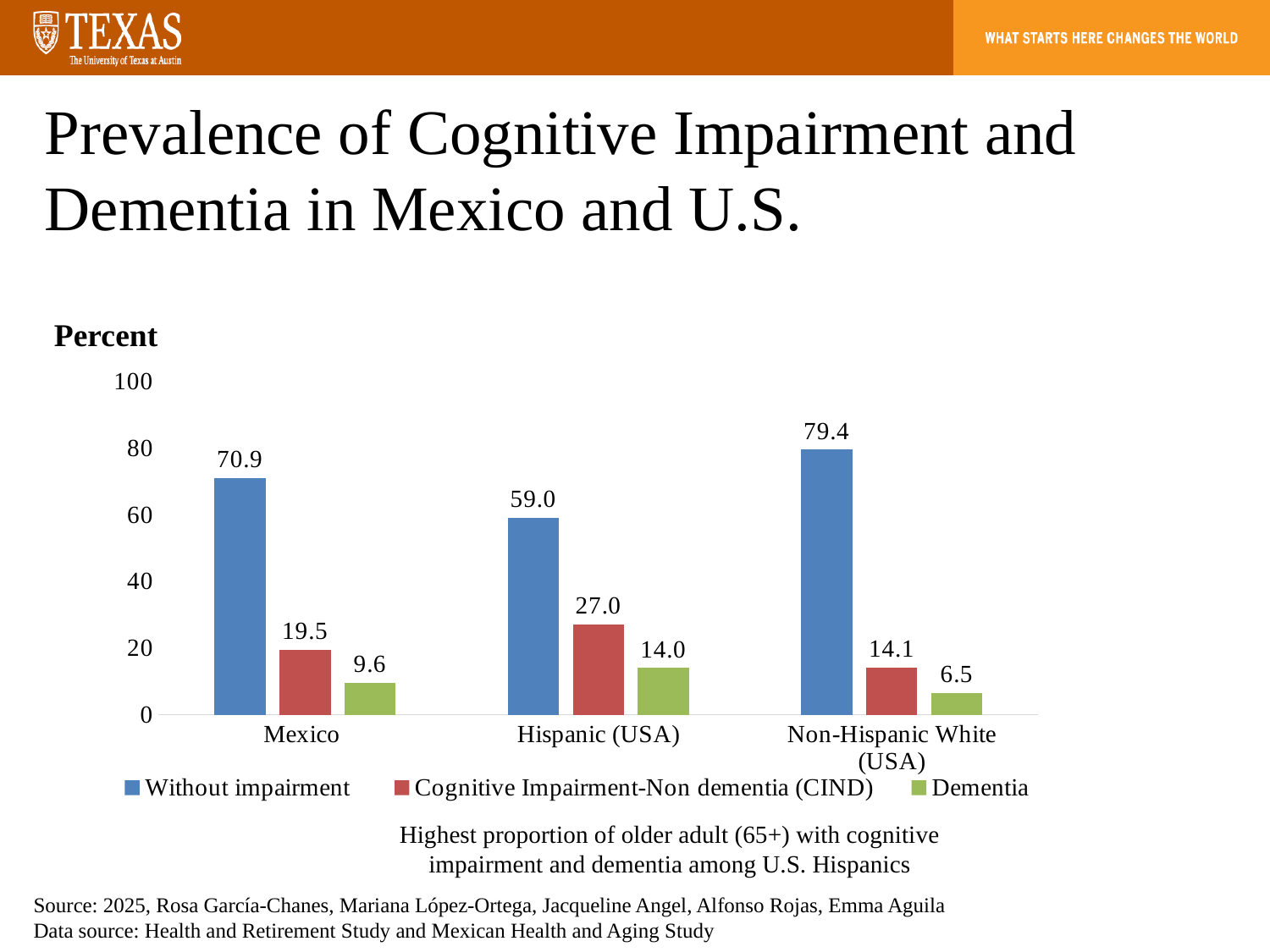
Is the value for Without impairment for Hispanic (USA) greater or less than 60? less How many series does the legend list? 3 What kind of chart is shown on the slide? bar chart What is the value for Without impairment in Mexico? 70.9 Which group has the lowest value for Dementia? Non-Hispanic White (USA) How many groups are shown on the x axis? 3 What is the label on the y axis of the chart? Percent What is the difference between the Dementia values for Hispanic (USA) and Mexico? 4.4 Which group has the highest value for Without impairment? Non-Hispanic White (USA) Which is larger: the CIND value for Mexico or for Non-Hispanic White (USA)? Mexico What is the value for Cognitive Impairment-Non dementia (CIND) for Hispanic (USA)? 27.0 What is the value for Dementia for Non-Hispanic White (USA)? 6.5